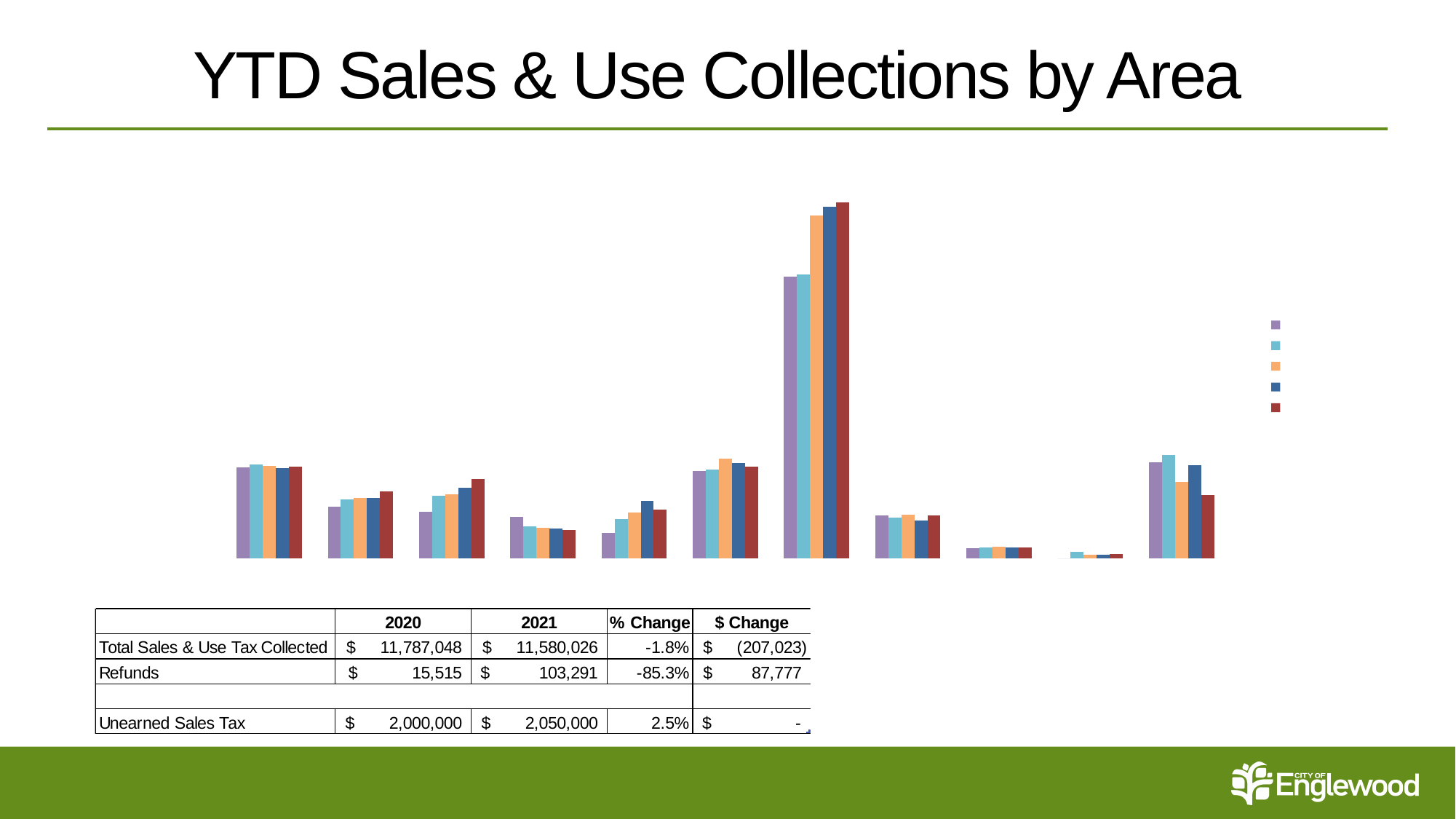
What colour is the first bar in each group of the chart? purple How many series does the chart's legend list? 5 Counting from the left, which group of bars is the tallest in the chart? the seventh group How many bars are in each group of the chart? 5 Does the chart's legend show any text labels next to its colour markers? No What kind of chart is shown on the slide? bar chart Counting from the left, which group of bars is the shortest in the chart? the tenth group How many groups of bars are plotted in the chart? 11